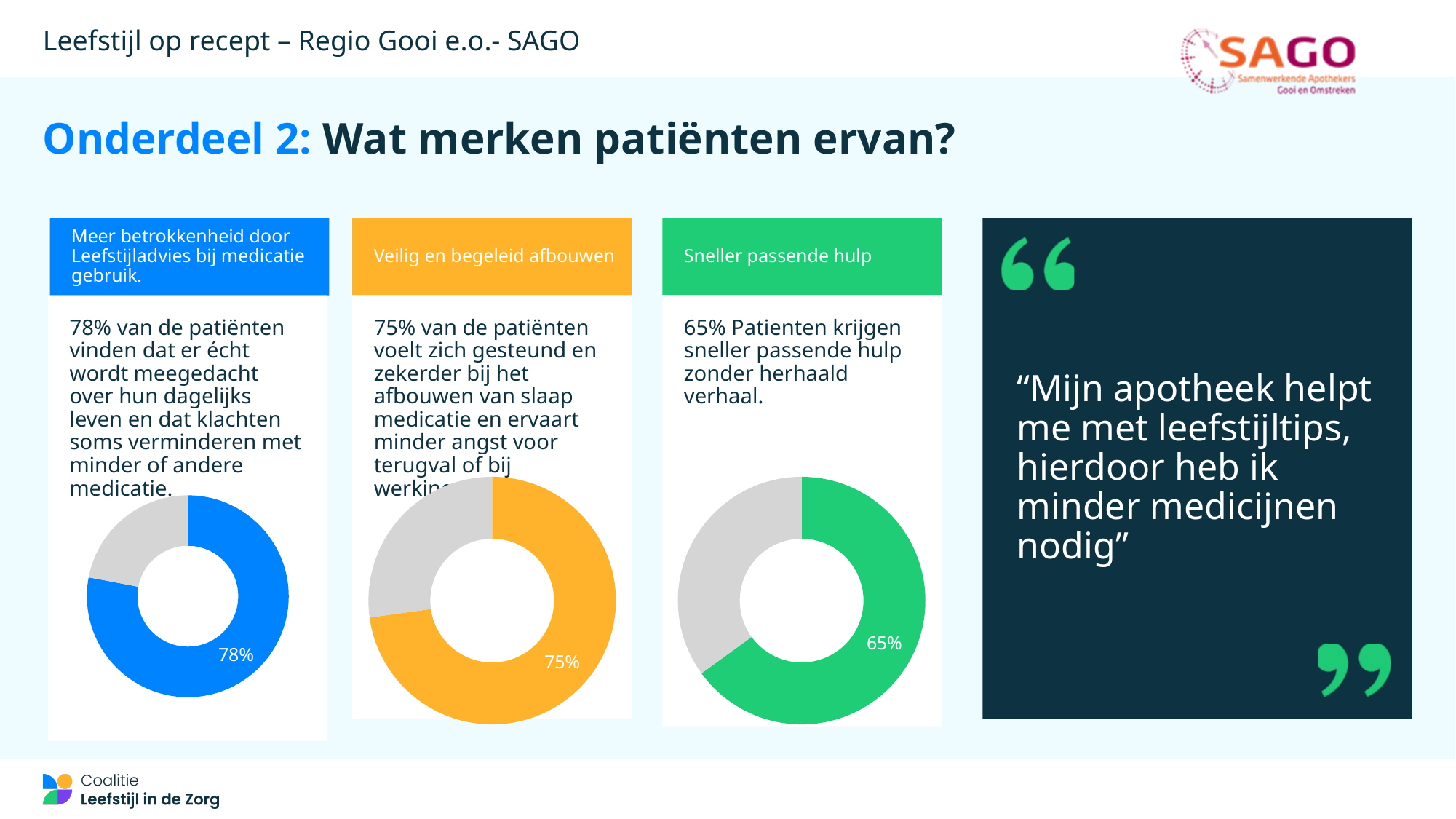
In the right donut chart ('Sneller passende hulp'), what share of the donut is the grey remainder? 35% In the right donut chart under 'Sneller passende hulp', what percentage is shown? 65% In the left donut chart under 'Meer betrokkenheid door Leefstijladvies bij medicatie gebruik', what percentage is shown? 78% What kind of chart is used in each of the three cards on the slide? Pie chart (donut) Which of the three donut charts shows the lowest percentage? The right chart (Sneller passende hulp), 65% What is the difference between the percentage in the left donut chart (78%) and the right donut chart (65%)? 13 percentage points What colour is the highlighted slice in the left donut chart ('Meer betrokkenheid')? Blue Which is larger: the percentage in the middle donut chart ('Veilig en begeleid afbouwen') or the right donut chart ('Sneller passende hulp')? The middle chart (75%) What is the difference between the percentage in the left donut chart (78%) and the middle donut chart (75%)? 3 percentage points Which of the three donut charts shows the highest percentage? The left chart (Meer betrokkenheid), 78% How many donut charts are shown on the slide? 3 In the middle donut chart under 'Veilig en begeleid afbouwen', what percentage is shown? 75%